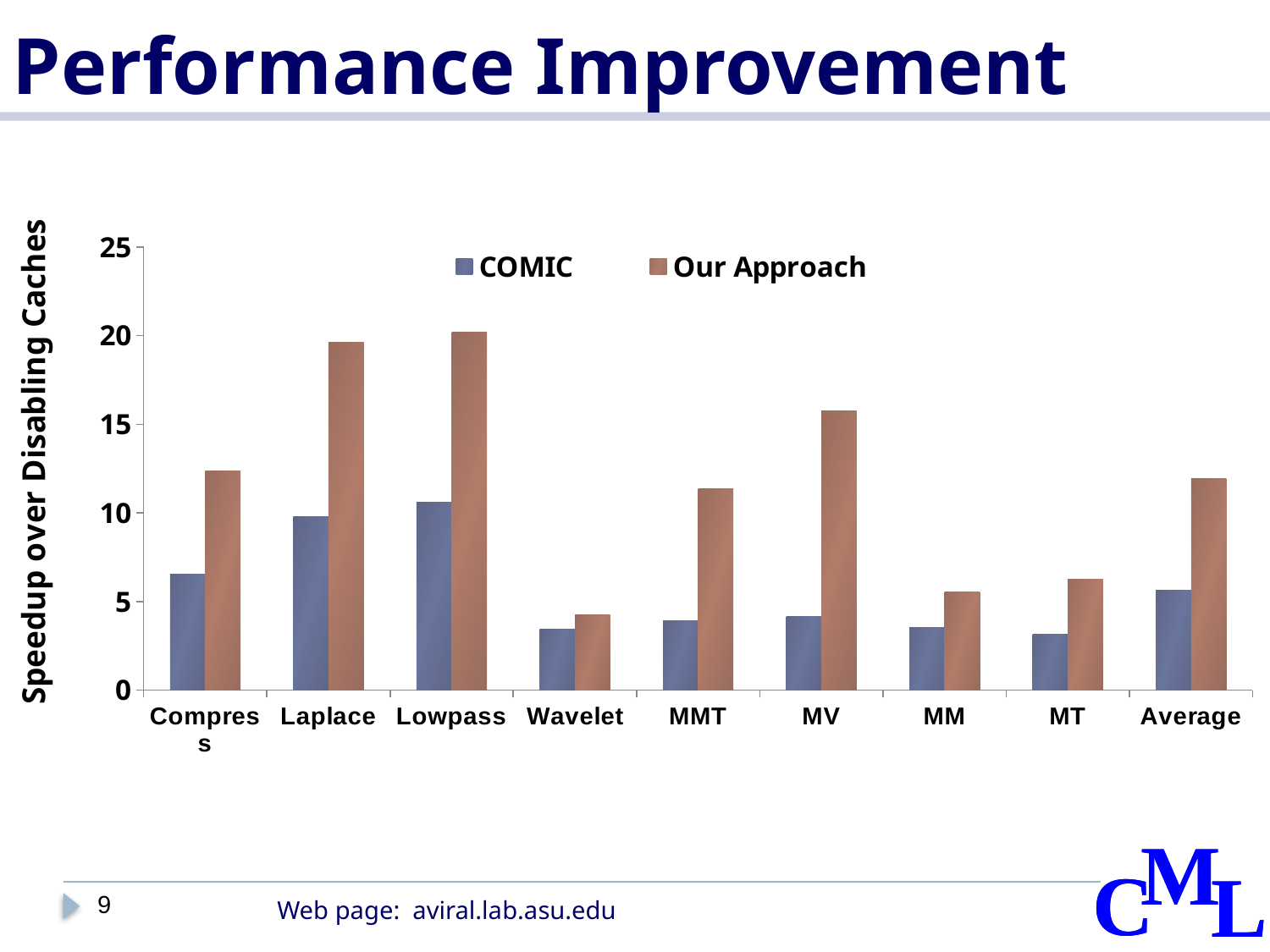
Which two series are listed in the legend? COMIC and Our Approach How many benchmark categories are shown on the x axis? 9 Is the Our Approach value for Laplace greater or less than 15? greater Is the COMIC value for Compress greater or less than 5? greater Is the Our Approach value for MMT greater or less than 10? greater Which category has the lowest Our Approach value? Wavelet What kind of chart is shown on the slide? bar chart What is the label of the vertical axis? Speedup over Disabling Caches For Compress, which series has the larger value, COMIC or Our Approach? Our Approach How many series does the legend list? 2